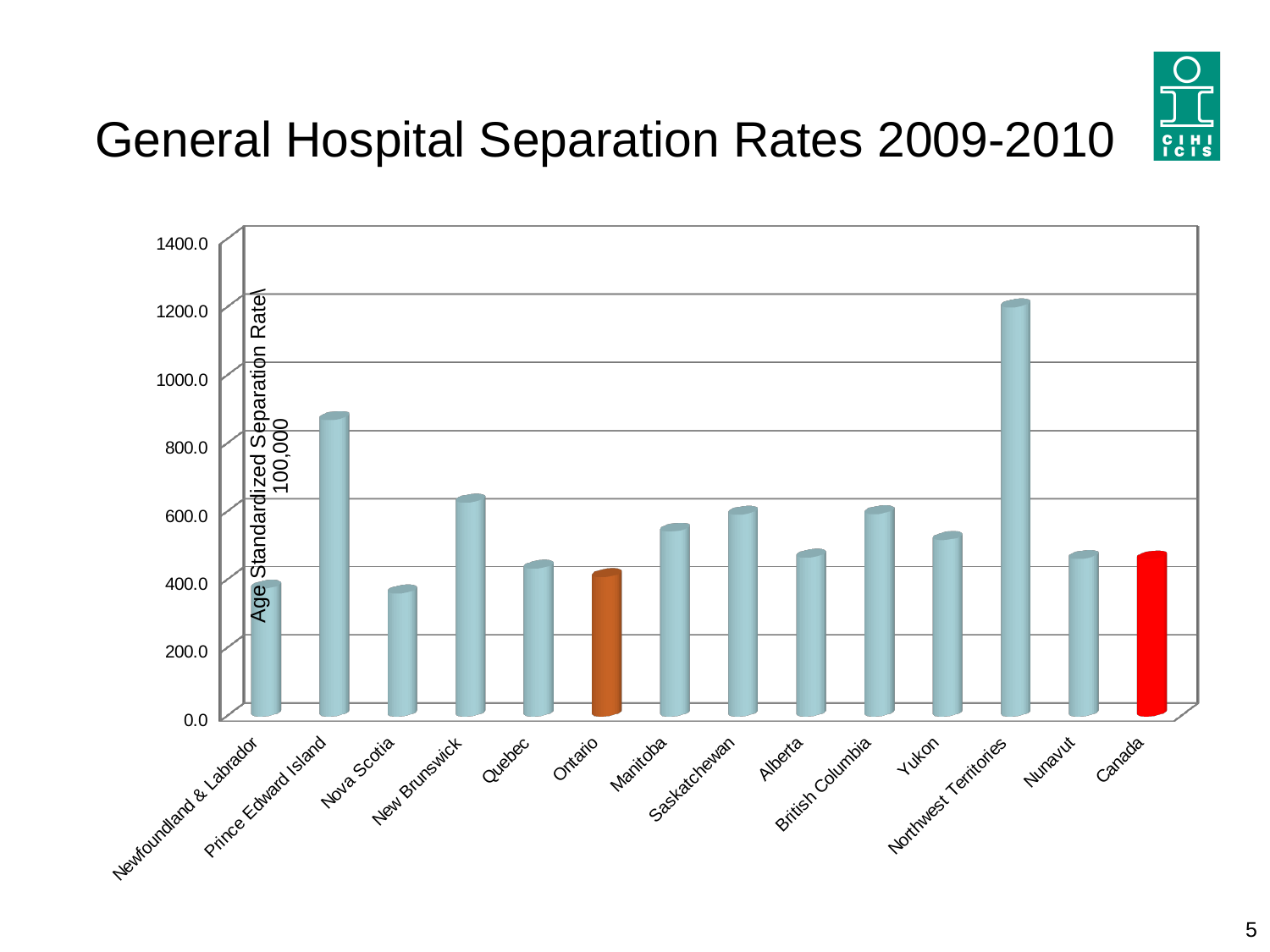
Which category's bar is coloured red? Canada Is the value for Ontario greater or less than 600.0? less What is the title of the chart on the slide? General Hospital Separation Rates 2009-2010 Is the value for Manitoba greater or less than 600.0? less What kind of chart is shown on the slide? bar chart Which has the larger separation rate, Ontario or Manitoba? Manitoba Which has the larger separation rate, Prince Edward Island or New Brunswick? Prince Edward Island How many categories (provinces, territories and Canada) are plotted on the chart? 14 Is the value for Nova Scotia greater or less than 400.0? less Which category has the highest separation rate? Northwest Territories